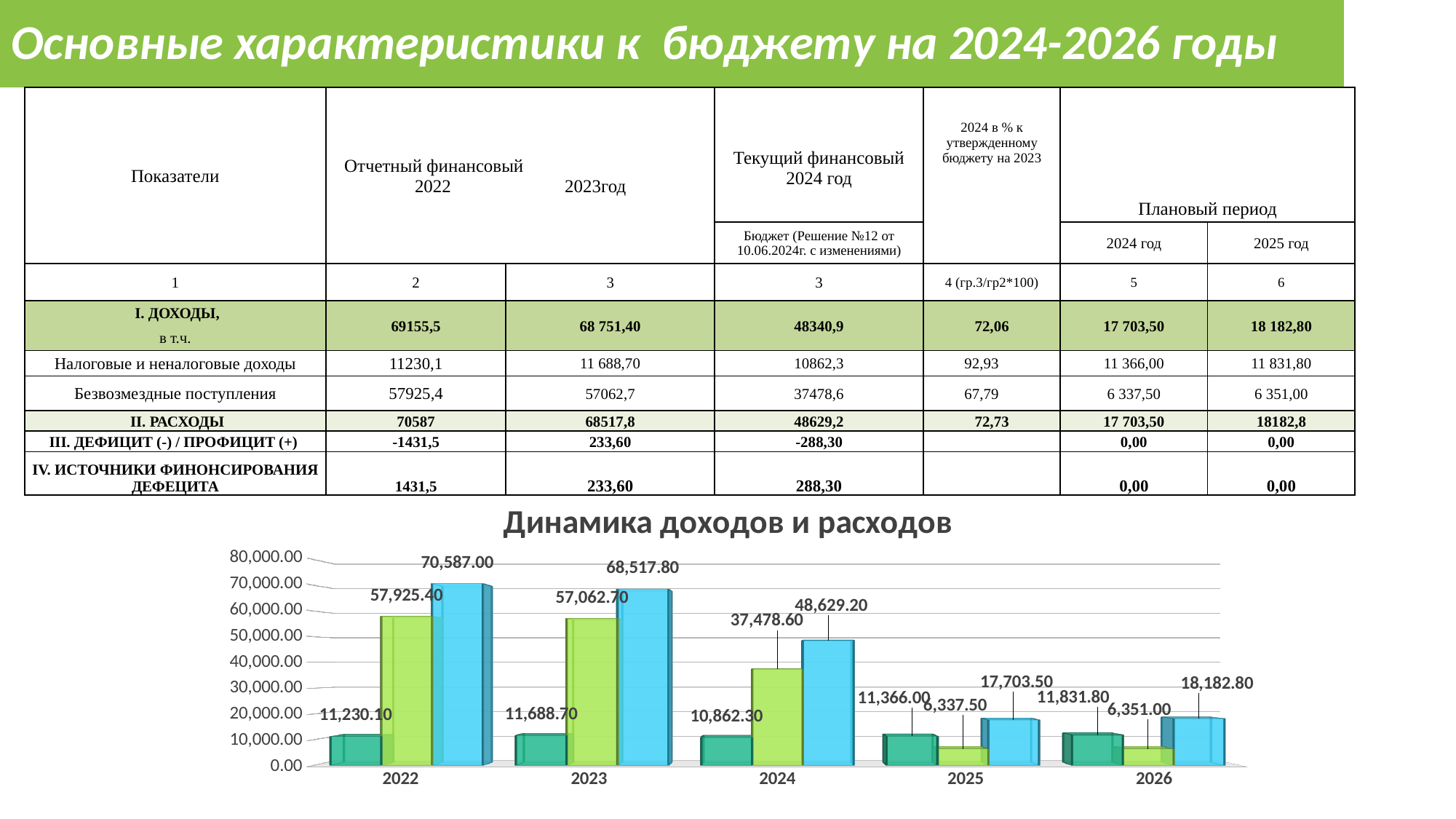
How many years (categories) are shown on the x axis of the chart? 5 In the chart, what is the value of the blue bar for 2022? 70,587.00 What is the title of the chart on the slide? Динамика доходов и расходов In the chart, which year has the highest blue bar? 2022 In the chart, do the blue bar values rise or fall from 2022 to 2025? fall In the chart, what is the difference between the blue bar values for 2022 and 2023? 2,069.20 What kind of chart is shown under the table? bar chart In the chart, what is the value of the dark green bar for 2026? 11,831.80 In the chart, what is the value of the light green bar for 2025? 6,337.50 In the chart, what is the value of the light green bar for 2024? 37,478.60 In the chart, for 2025, which is larger: the dark green bar or the light green bar? the dark green bar In the chart, which year has the lowest blue bar? 2025